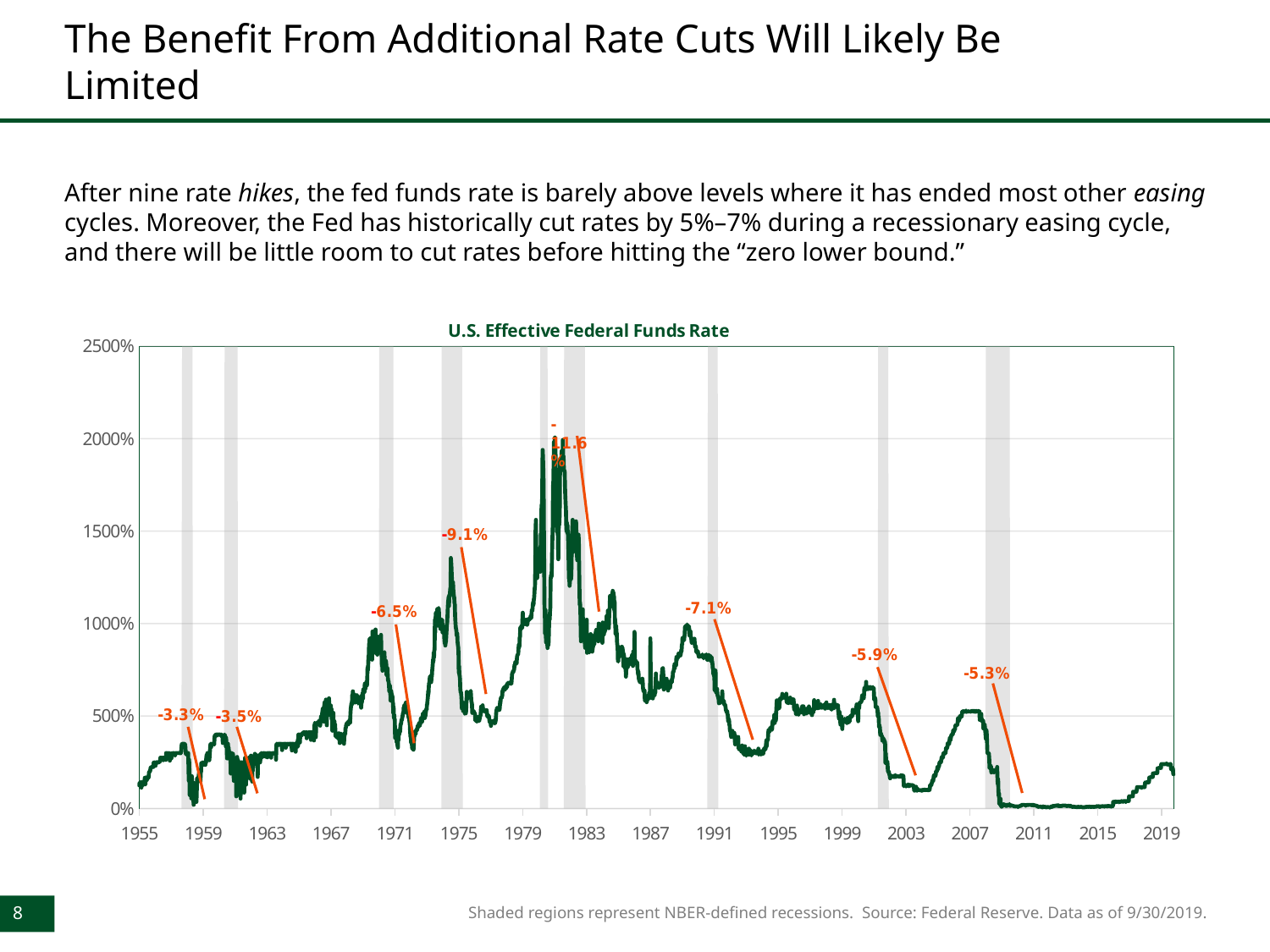
How many rate-cut annotations are labeled on the chart? 8 Is the federal funds rate in 2015 greater or less than 500% on the y axis? less What is the title of the chart? U.S. Effective Federal Funds Rate What rate cut is annotated for the easing cycle that began around 2007? -5.3% Is the peak of the federal funds rate around 1981 greater or less than 1500% on the y axis? greater What is the largest rate cut annotated on the chart? -11.6% What rate cut is annotated for the easing cycle that began around 1974? -9.1% Which annotated rate cut is larger in magnitude: the one labeled -7.1% around 1989 or the one labeled -5.9% around 2000? -7.1% What is the smallest rate cut annotated on the chart? -3.3% What type of chart is shown on the slide? Line chart What is the difference in magnitude between the -9.1% and -6.5% annotated rate cuts? 2.6 percentage points What rate cut is annotated for the easing cycle that began around 1989? -7.1%